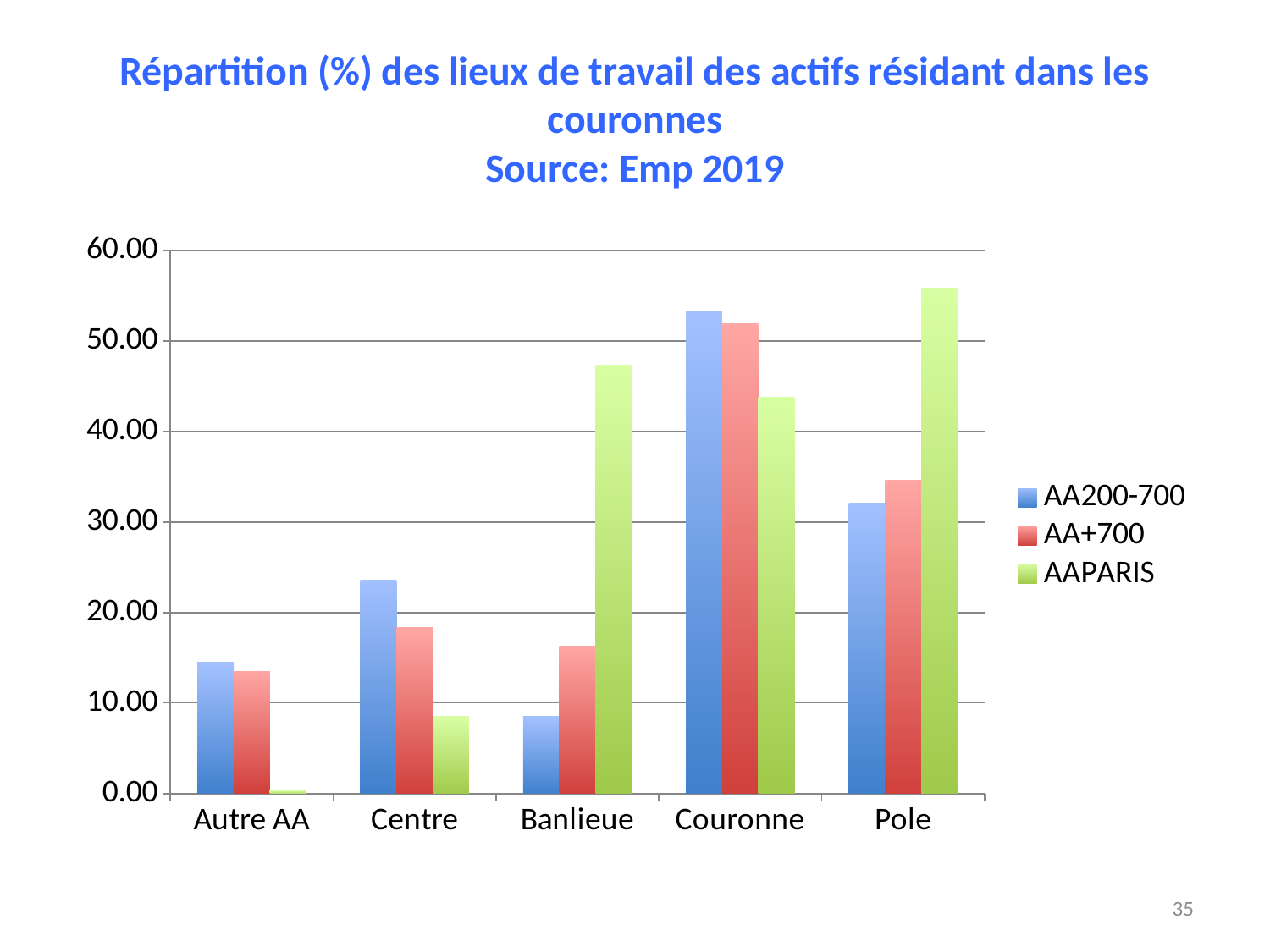
Which category has the lowest value for the AAPARIS series? Autre AA Which series is shown in green in the legend? AAPARIS Is the value for AA200-700 in Centre greater or less than 20.00? greater How many series does the legend list? 3 Is the value for AAPARIS in Banlieue greater or less than 40.00? greater Which category has the highest value for the AAPARIS series? Pole Which category has the lowest value for the AA200-700 series? Banlieue How many categories are shown on the x axis? 5 Is the value for AA+700 in Pole greater or less than 40.00? less What kind of chart is shown on the slide? bar chart Which category has the highest value for the AA200-700 series? Couronne In Banlieue, which series has the larger value, AAPARIS or AA+700? AAPARIS